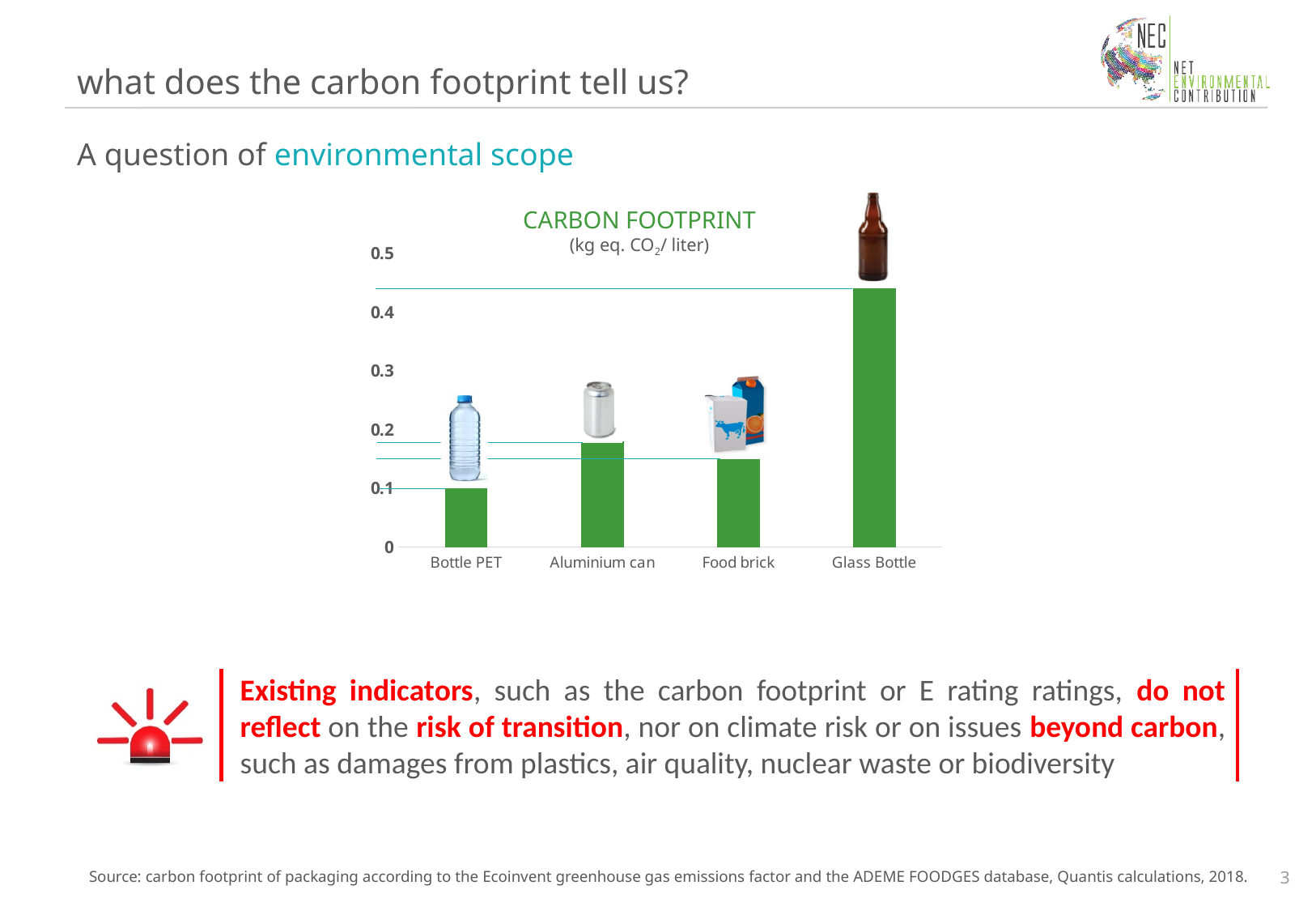
Is the value for Aluminium can greater or less than 0.2? less What is the title of the chart? CARBON FOOTPRINT Is the value for Bottle PET greater or less than 0.2? less Is the value for Glass Bottle greater or less than 0.4? greater Which has the larger carbon footprint, Glass Bottle or Bottle PET? Glass Bottle In what unit are the chart values expressed, according to the chart subtitle? kg eq. CO2/ liter How many packaging categories are shown on the x axis of the chart? 4 Which packaging type has the highest carbon footprint in the chart? Glass Bottle What kind of chart is shown on the slide? bar chart Which packaging type has the lowest carbon footprint in the chart? Bottle PET Which has the larger carbon footprint, Aluminium can or Food brick? Aluminium can